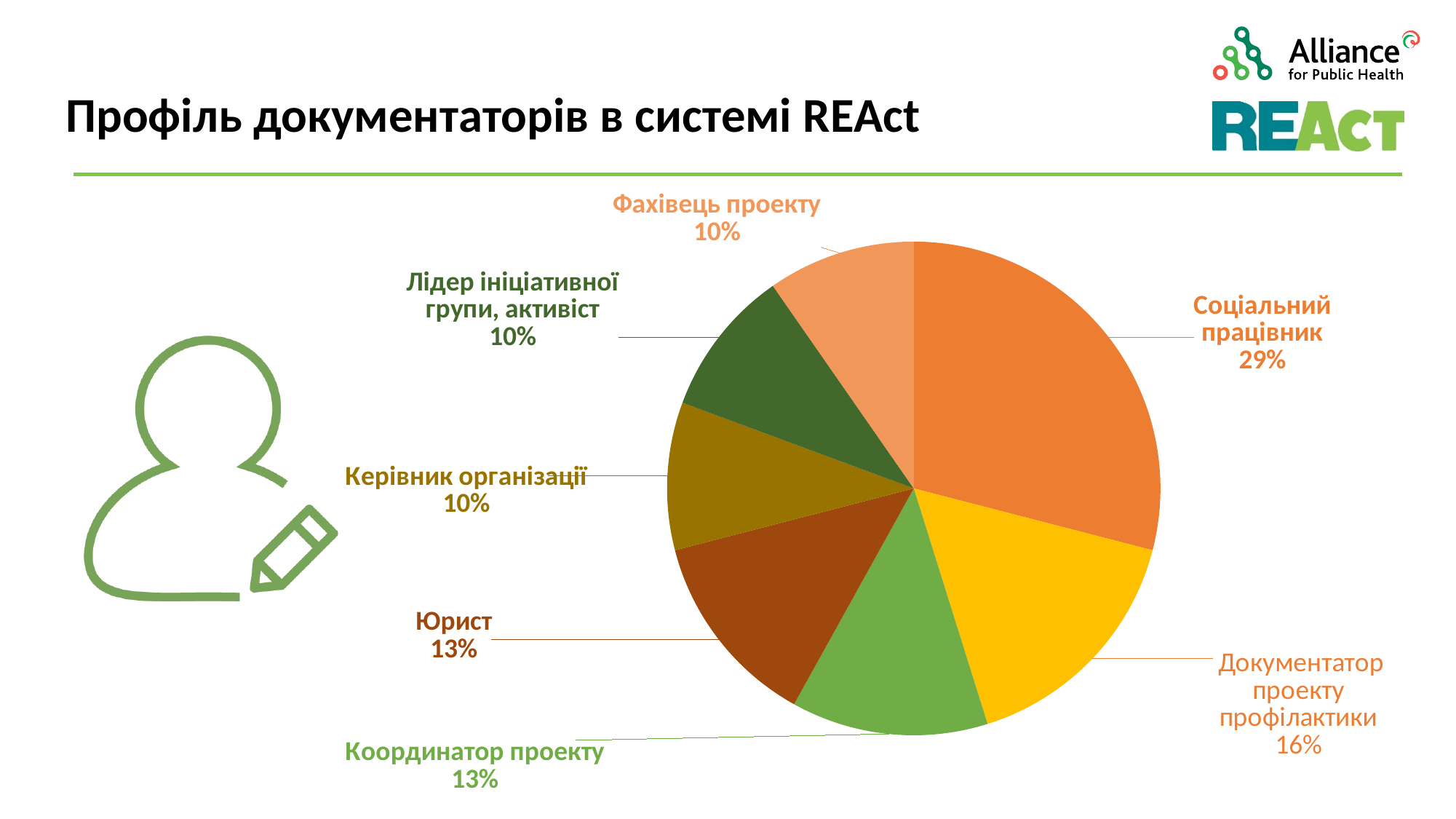
What is the difference between the shares for "Соціальний працівник" and "Документатор проекту профілактики"? 13% What share of the pie is labelled "Документатор проекту профілактики"? 16% Which category has the largest slice of the pie? Соціальний працівник What is the value shown for "Координатор проекту"? 13% How many categories are shown with a value of 10%? 3 What share of the pie is labelled "Соціальний працівник"? 29% What is the title of the slide containing the pie chart? Профіль документаторів в системі REAct What kind of chart is shown on the slide? Pie chart How many slices does the pie chart have? 7 What is the value shown for "Керівник організації"? 10% What is the value shown for "Юрист"? 13% Which is larger: the share for "Юрист" or the share for "Фахівець проекту"? Юрист